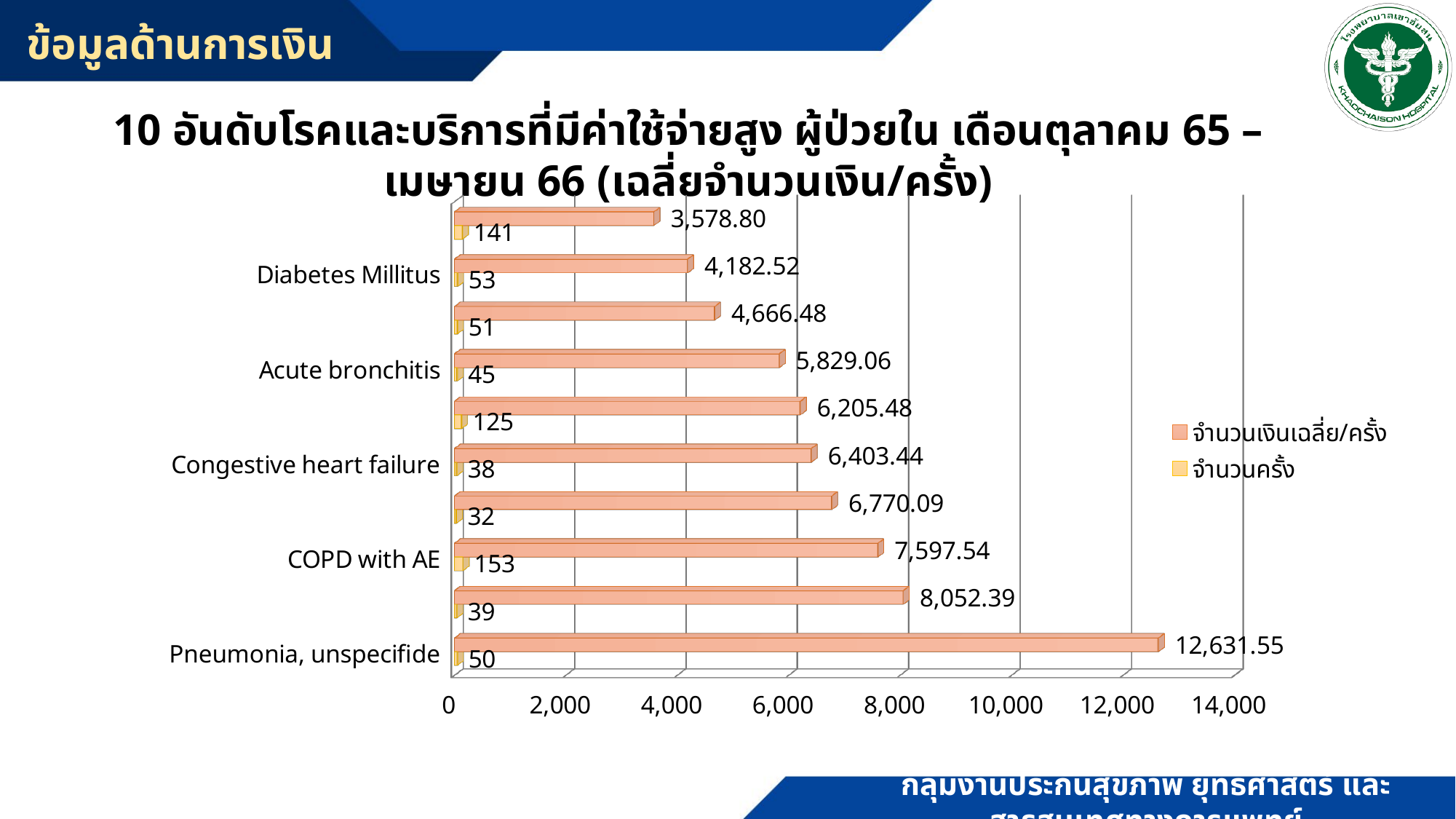
What is the number of visits (จำนวนครั้ง) for COPD with AE? 153 What is the difference in average cost per visit between Pneumonia, unspecifide and COPD with AE? 5,034.01 What is the average cost per visit (จำนวนเงินเฉลี่ย/ครั้ง) for COPD with AE? 7,597.54 What is the average cost per visit (จำนวนเงินเฉลี่ย/ครั้ง) for Congestive heart failure? 6,403.44 What is the number of visits (จำนวนครั้ง) for Diabetes Millitus? 53 Which category has the highest average cost per visit (จำนวนเงินเฉลี่ย/ครั้ง)? Pneumonia, unspecifide How many series does the legend list? 2 How many categories are plotted in the chart? 10 Which has a higher average cost per visit, Acute bronchitis or Congestive heart failure? Congestive heart failure Which category has the highest number of visits (จำนวนครั้ง)? COPD with AE What kind of chart is shown on the slide? Bar chart What is the average cost per visit (จำนวนเงินเฉลี่ย/ครั้ง) for Pneumonia, unspecifide? 12,631.55